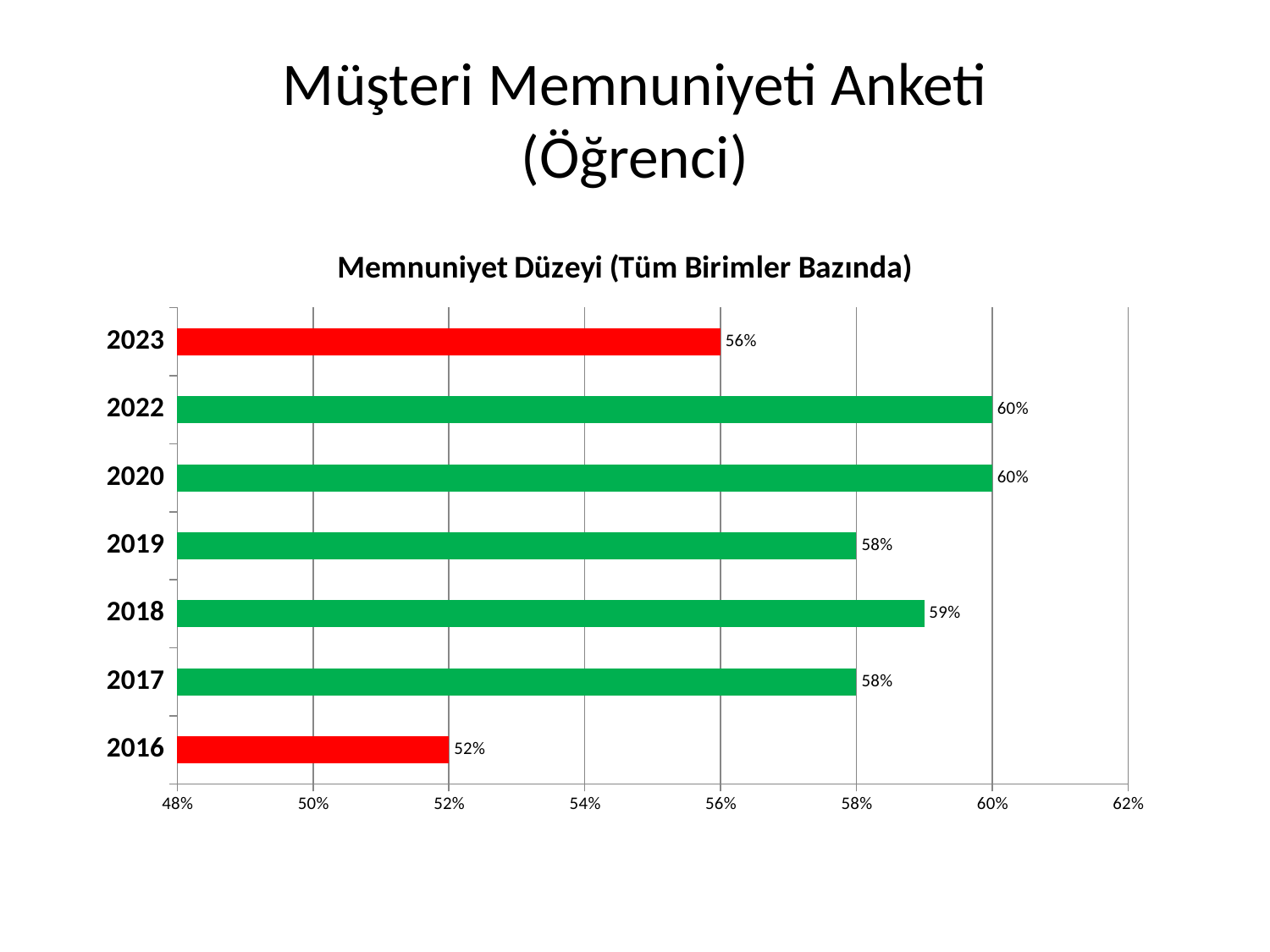
What is the difference between the satisfaction levels for 2022 and 2023? 4% Which year has the lowest satisfaction level? 2016 What is the title of the chart? Memnuniyet Düzeyi (Tüm Birimler Bazında) How many years are shown on the chart? 7 What is the satisfaction level for 2016? 52% Which is larger, the value for 2019 or the value for 2018? 2018 What kind of chart is shown on the slide? bar chart Is the value for 2023 greater or less than 58%? less What is the satisfaction level for 2023? 56% Which years are shown with red bars? 2016 and 2023 What is the difference between the satisfaction levels for 2018 and 2016? 7% What is the satisfaction level for 2018? 59%